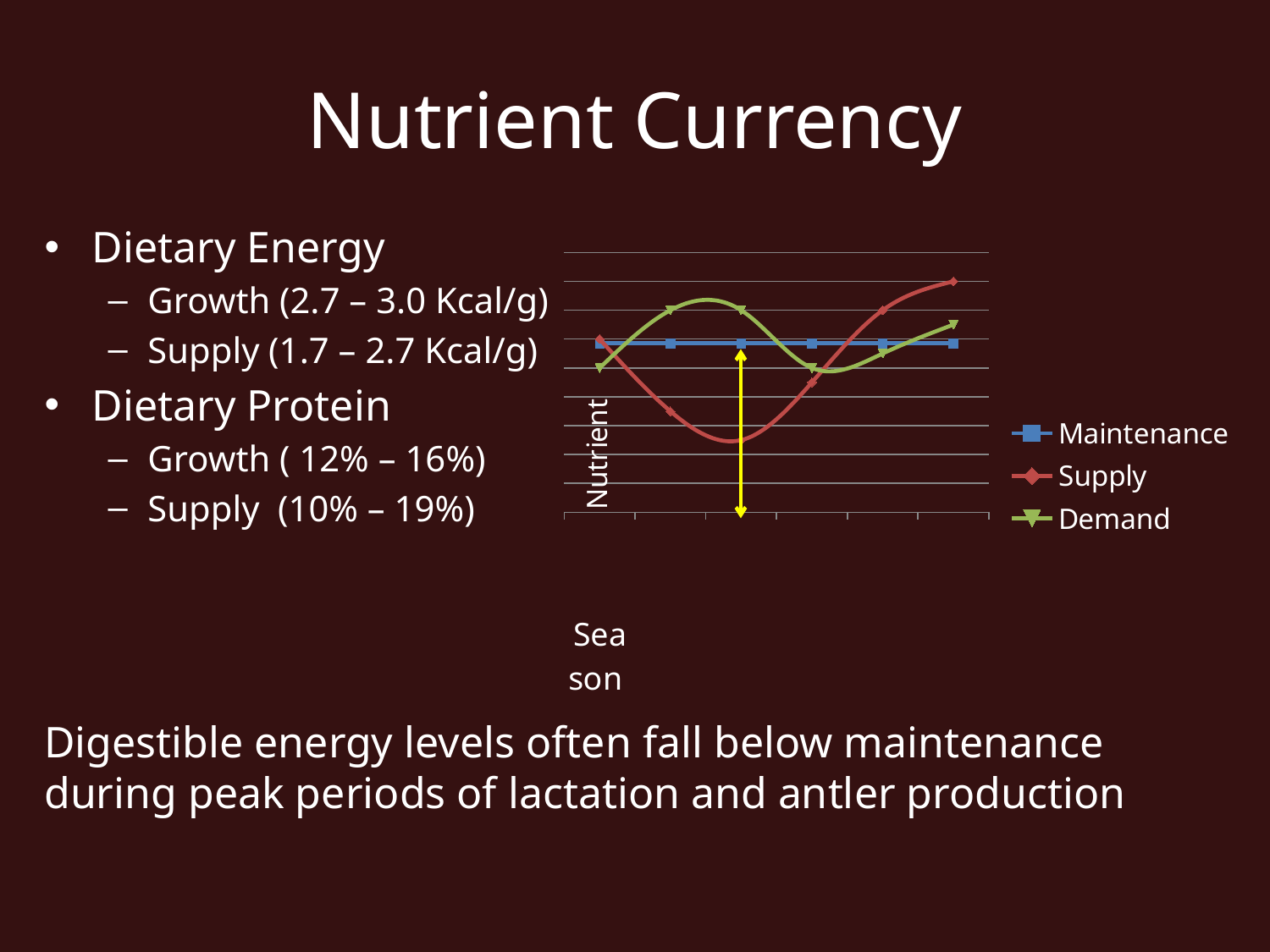
At the third point from the left, is the Supply value larger or smaller than the Demand value? smaller How many series does the chart's legend list? 3 Does the Supply series rise or fall over its last three points? rise How many data points are plotted for the Maintenance series? 6 Does the Supply series rise or fall over its first three points? fall Which series stays flat across the whole x axis? Maintenance At the rightmost point, is the Supply value larger or smaller than the Maintenance value? larger What kind of chart is shown on the slide? line chart What is the label on the chart's vertical axis? Nutrient At the leftmost point of the chart, which series has the lowest value? Demand At the rightmost point of the chart, which series has the highest value? Supply What are the three series named in the chart's legend? Maintenance, Supply, Demand